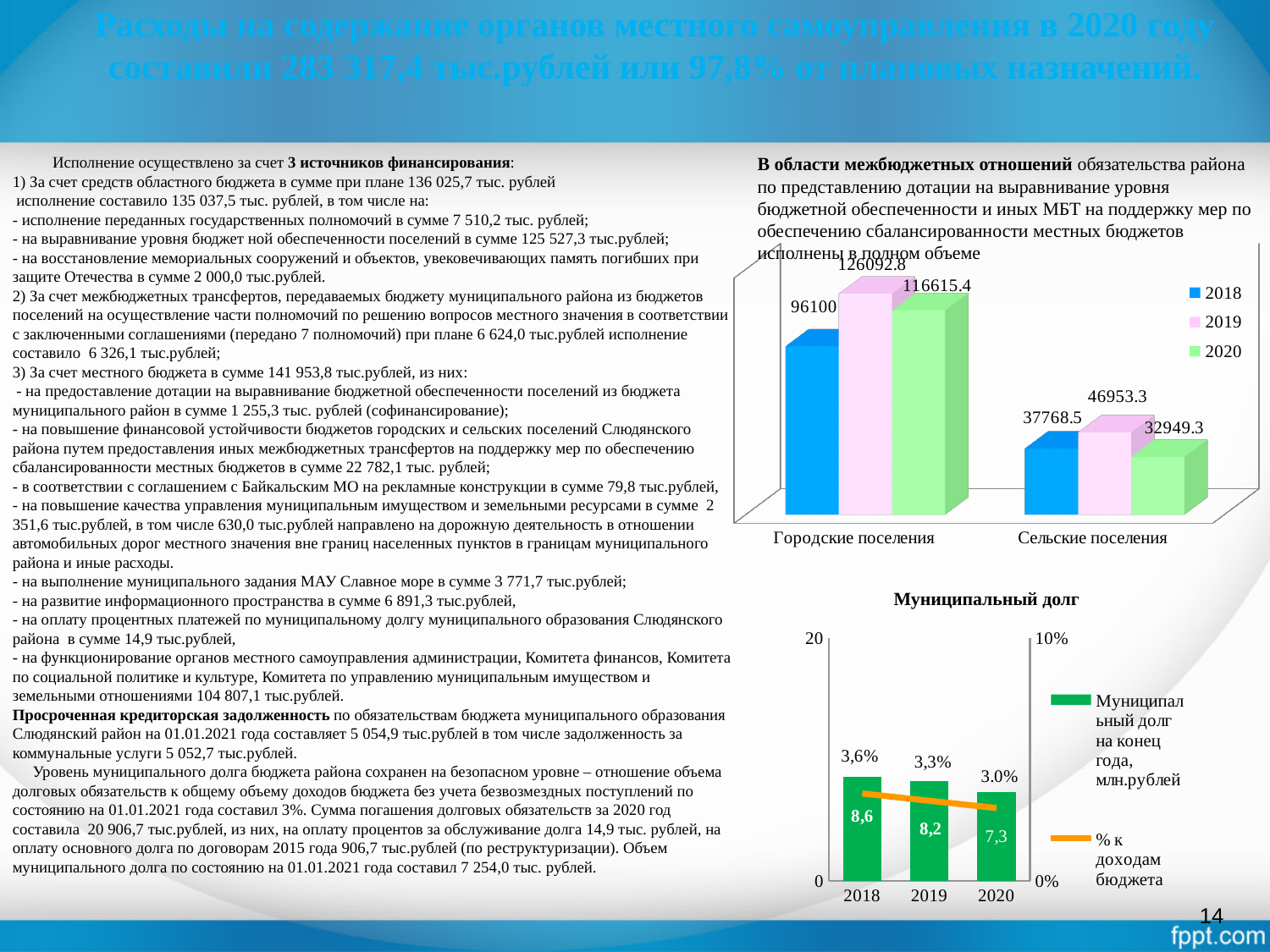
In the top-right bar chart, what is the value for Городские поселения in 2019? 126092.8 In the top-right bar chart, what is the value for Сельские поселения in 2020? 32949.3 How many series does the legend of the top-right bar chart list? 3 In the top-right bar chart, which year has the lowest value for Городские поселения? 2018 In the chart titled Муниципальный долг, do the municipal debt bars rise or fall from 2018 to 2020? fall How many years are shown on the x axis of the chart titled Муниципальный долг? 3 In the chart titled Муниципальный долг, what is the municipal debt value for 2019? 8,2 In the top-right bar chart, what is the difference between the 2019 and 2018 values for Сельские поселения? 9184.8 What kind of chart is the top-right chart showing Городские поселения and Сельские поселения? bar chart In the top-right bar chart, which is larger: the 2020 value for Городские поселения or the 2019 value for Городские поселения? 2019 In the chart titled Муниципальный долг, what is the percentage of budget revenues for 2018? 3,6% In the top-right bar chart, which year has the highest value for Сельские поселения? 2019